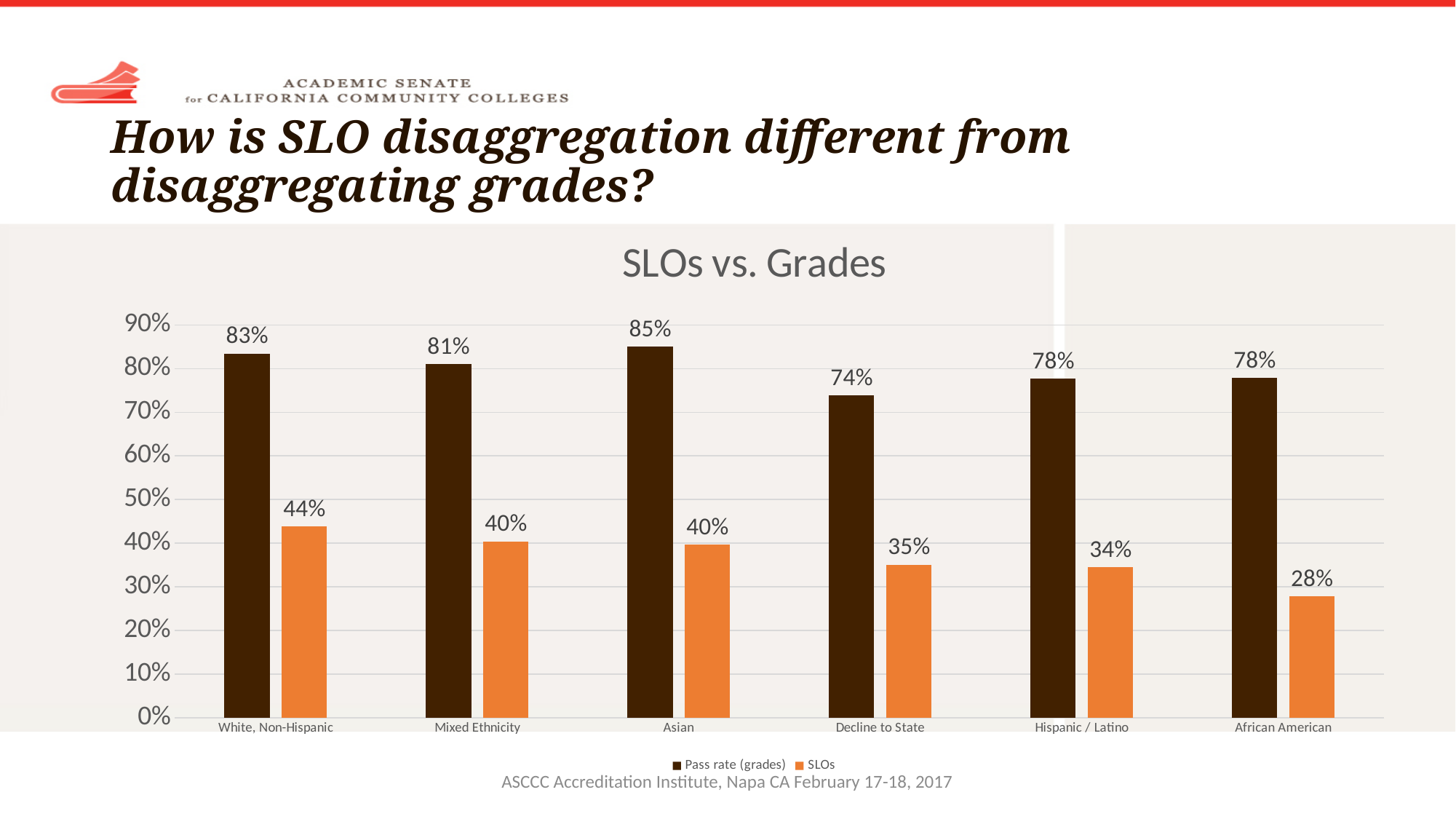
What is the SLOs value for African American? 28% How many series does the legend list? 2 What is the pass rate (grades) for Asian? 85% Which series is shown in orange? SLOs How many categories are shown on the x axis? 6 Which category has the highest pass rate (grades)? Asian What is the SLOs value for Decline to State? 35% What kind of chart is shown? Bar chart What is the title of the chart? SLOs vs. Grades What is the difference between the pass rate (grades) and the SLOs value for White, Non-Hispanic? 39% Which category has the lowest SLOs value? African American Which is larger: the SLOs value for Hispanic / Latino or the SLOs value for White, Non-Hispanic? White, Non-Hispanic